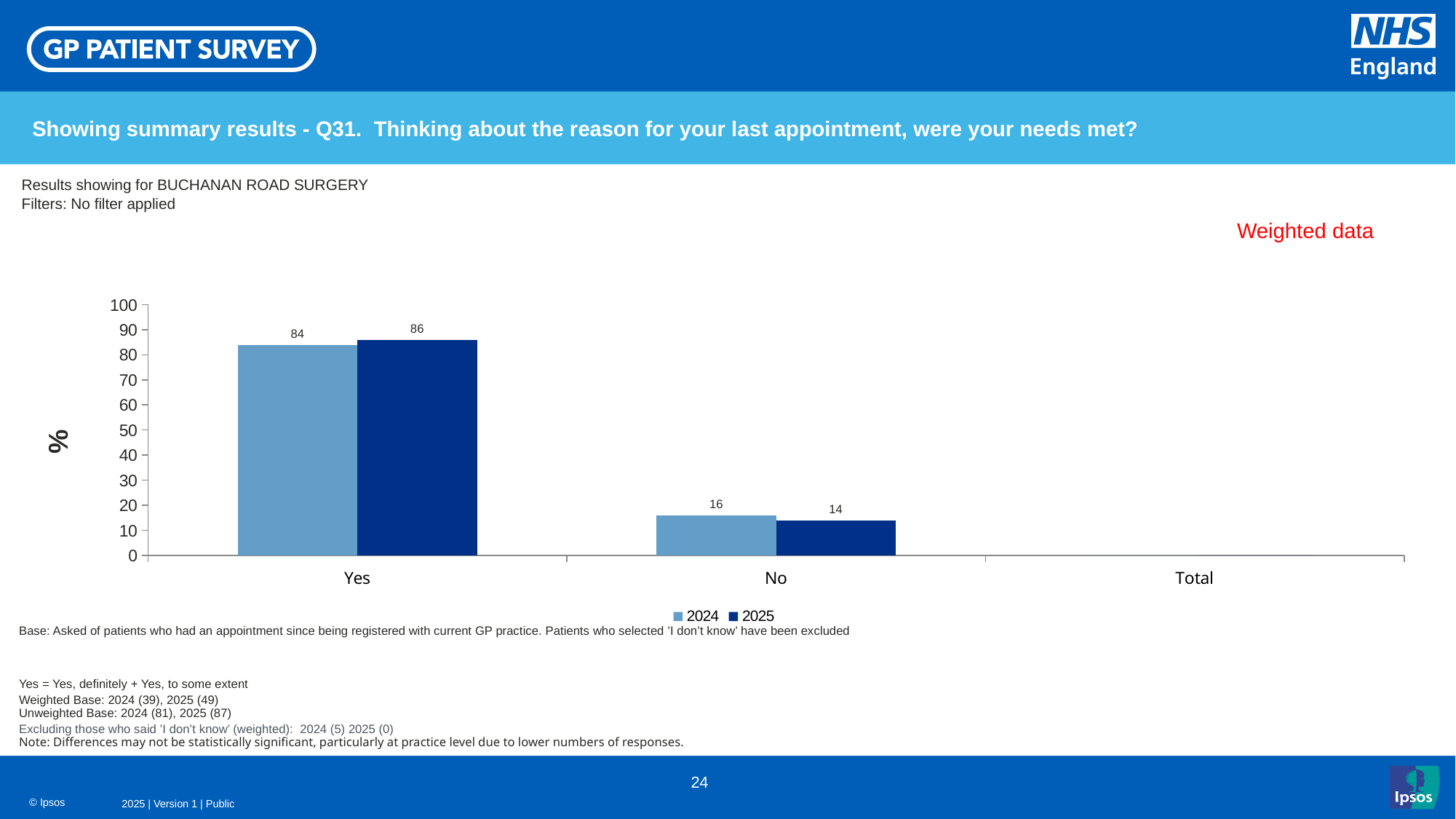
What is the value for No in 2025? 14 What is the value for Yes in 2024? 84 How many series does the legend list? 2 Which category has the highest value in 2025? Yes What kind of chart is shown on the slide? Bar chart What is the value for Yes in 2025? 86 What is the difference between the 2025 and 2024 values for Yes? 2 What is the value for No in 2024? 16 What are the two series listed in the legend? 2024 and 2025 Which is larger, the 2024 value for Yes or the 2024 value for No? 2024 value for Yes What is the difference between the 2024 and 2025 values for No? 2 Which category has the lowest value in 2024? No